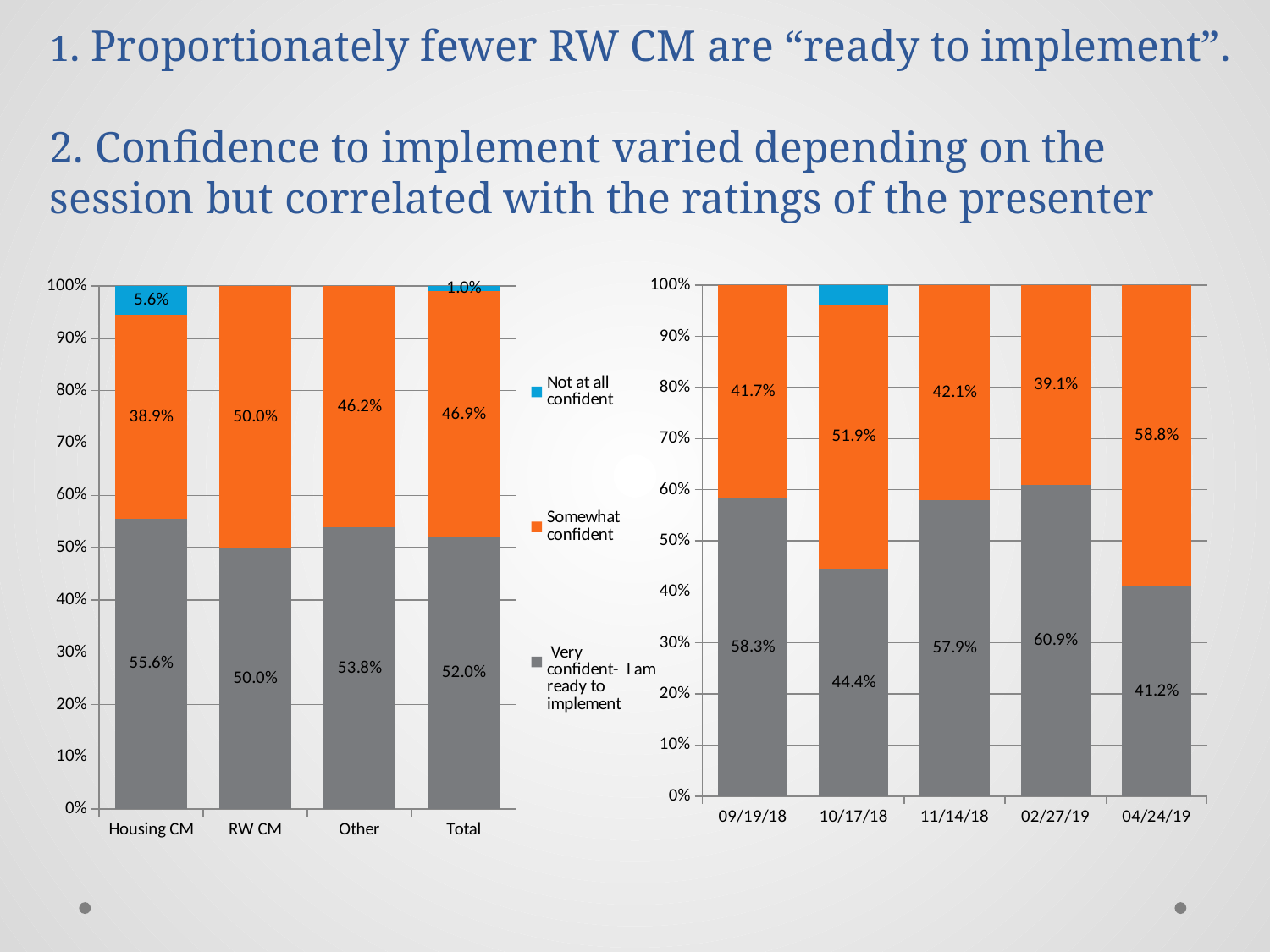
In the left chart, what percentage of Housing CM respondents were very confident (ready to implement)? 55.6% In the left chart, what is the somewhat confident percentage for the Total category? 46.9% In the left chart, what percentage of Housing CM respondents were not at all confident? 5.6% In the right chart, which session has the highest very confident (ready to implement) percentage? 02/27/19 In the right chart, which session has the lowest very confident (ready to implement) percentage? 04/24/19 In the right chart, is the very confident percentage for 10/17/18 greater or less than 50%? less In the right chart, what is the very confident (ready to implement) percentage for the 02/27/19 session? 60.9% How many series does the legend between the two charts list? 3 In the right chart, what is the somewhat confident percentage for the 04/24/19 session? 58.8% In the left chart, which category has the lowest very confident (ready to implement) percentage? RW CM How many sessions are shown on the x axis of the right chart? 5 In the left chart, what is the difference between the very confident percentages for Housing CM and RW CM? 5.6%